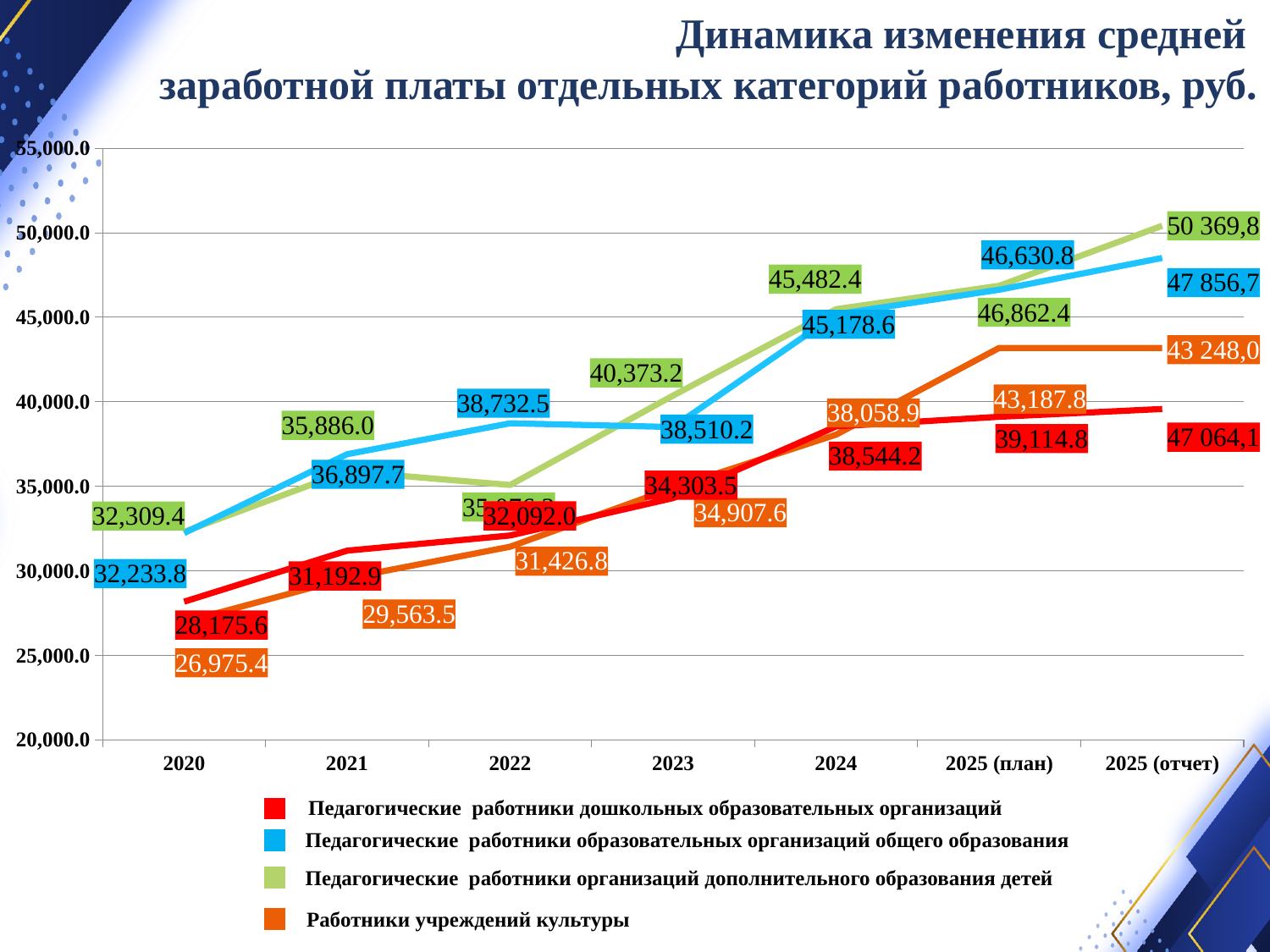
What type of chart is shown on the slide? line chart How many categories are shown on the x axis? 7 Which series has the lowest value in 2020? Работники учреждений культуры Does the value for Работники учреждений культуры rise or fall from 2020 to 2025 (отчет)? rise What is the value for Педагогические работники организаций дополнительного образования детей in 2023? 40,373.2 What is the difference between the 2024 and 2023 values for Педагогические работники образовательных организаций общего образования? 6,668.4 What is the value for Педагогические работники дошкольных образовательных организаций in 2024? 38,544.2 Which series has the highest value in 2025 (отчет)? Педагогические работники организаций дополнительного образования детей How many series does the legend list? 4 In 2021, which is larger: the value for Педагогические работники образовательных организаций общего образования or for Педагогические работники организаций дополнительного образования детей? Педагогические работники образовательных организаций общего образования What is the value for Работники учреждений культуры in 2021? 29,563.5 What is the value for Педагогические работники образовательных организаций общего образования in 2020? 32,233.8